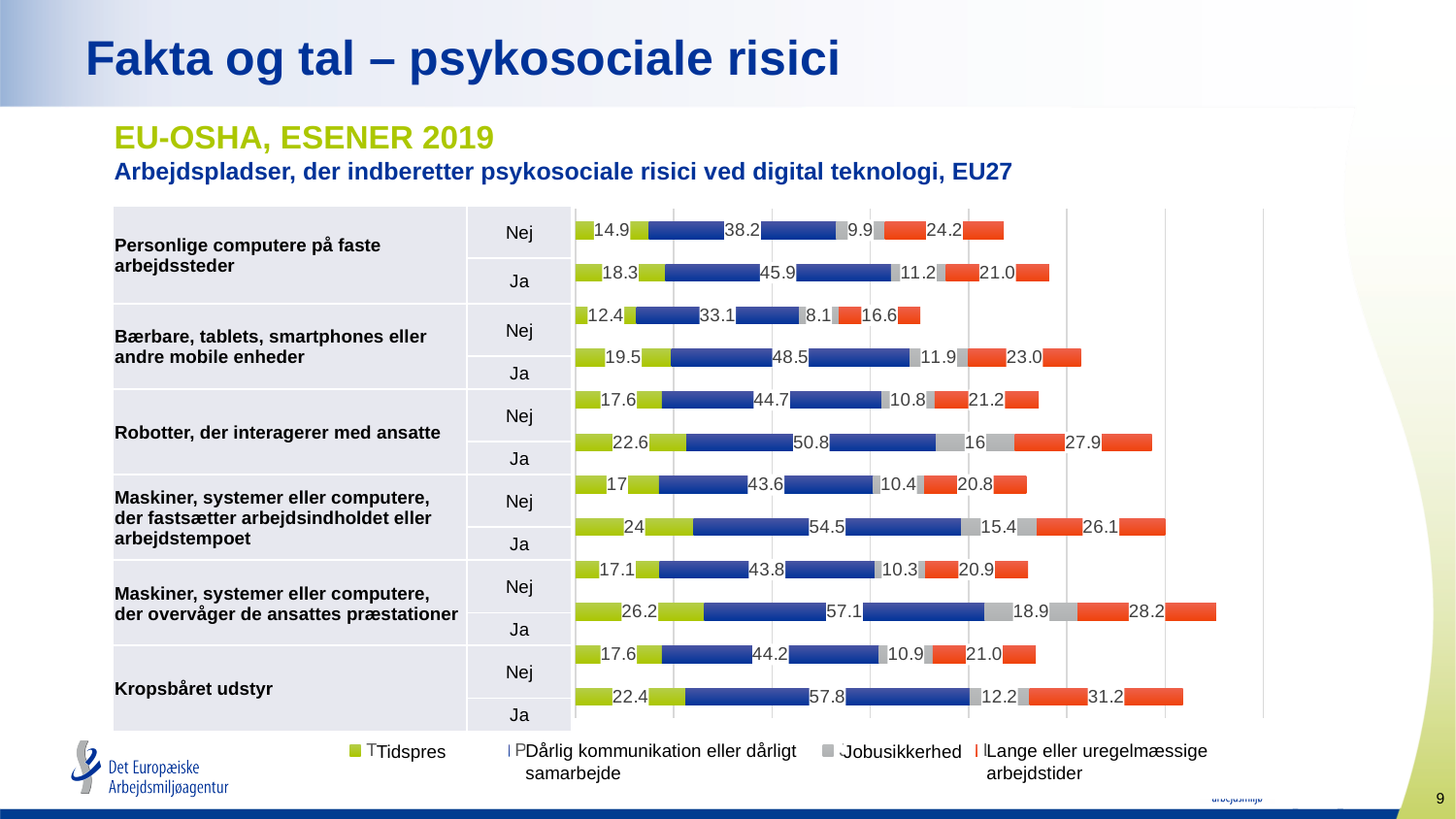
How many bars are plotted in the chart? 12 Which row has the highest 'Dårlig kommunikation eller dårligt samarbejde' value? Kropsbåret udstyr, Ja What is the total of the stacked bar for the 'Nej' row of 'Bærbare, tablets, smartphones eller andre mobile enheder'? 70.2 What is the Tidspres value for the 'Ja' row of 'Kropsbåret udstyr'? 22.4 What is the difference between the Tidspres values for the 'Ja' and 'Nej' rows of 'Maskiner, systemer eller computere, der overvåger de ansattes præstationer'? 9.1 Which row has the lowest Tidspres value? Bærbare, tablets, smartphones eller andre mobile enheder, Nej What is the Jobusikkerhed value for the 'Ja' row of 'Robotter, der interagerer med ansatte'? 16 What is the 'Lange eller uregelmæssige arbejdstider' value for the 'Ja' row of 'Bærbare, tablets, smartphones eller andre mobile enheder'? 23.0 What kind of chart is shown on the slide? Stacked bar chart How many series does the legend list? 4 What is the 'Dårlig kommunikation eller dårligt samarbejde' value for the 'Nej' row of 'Personlige computere på faste arbejdssteder'? 38.2 Which is larger: the Jobusikkerhed value for the 'Ja' row of 'Maskiner, systemer eller computere, der overvåger de ansattes præstationer' or for the 'Ja' row of 'Kropsbåret udstyr'? Maskiner, systemer eller computere, der overvåger de ansattes præstationer, Ja